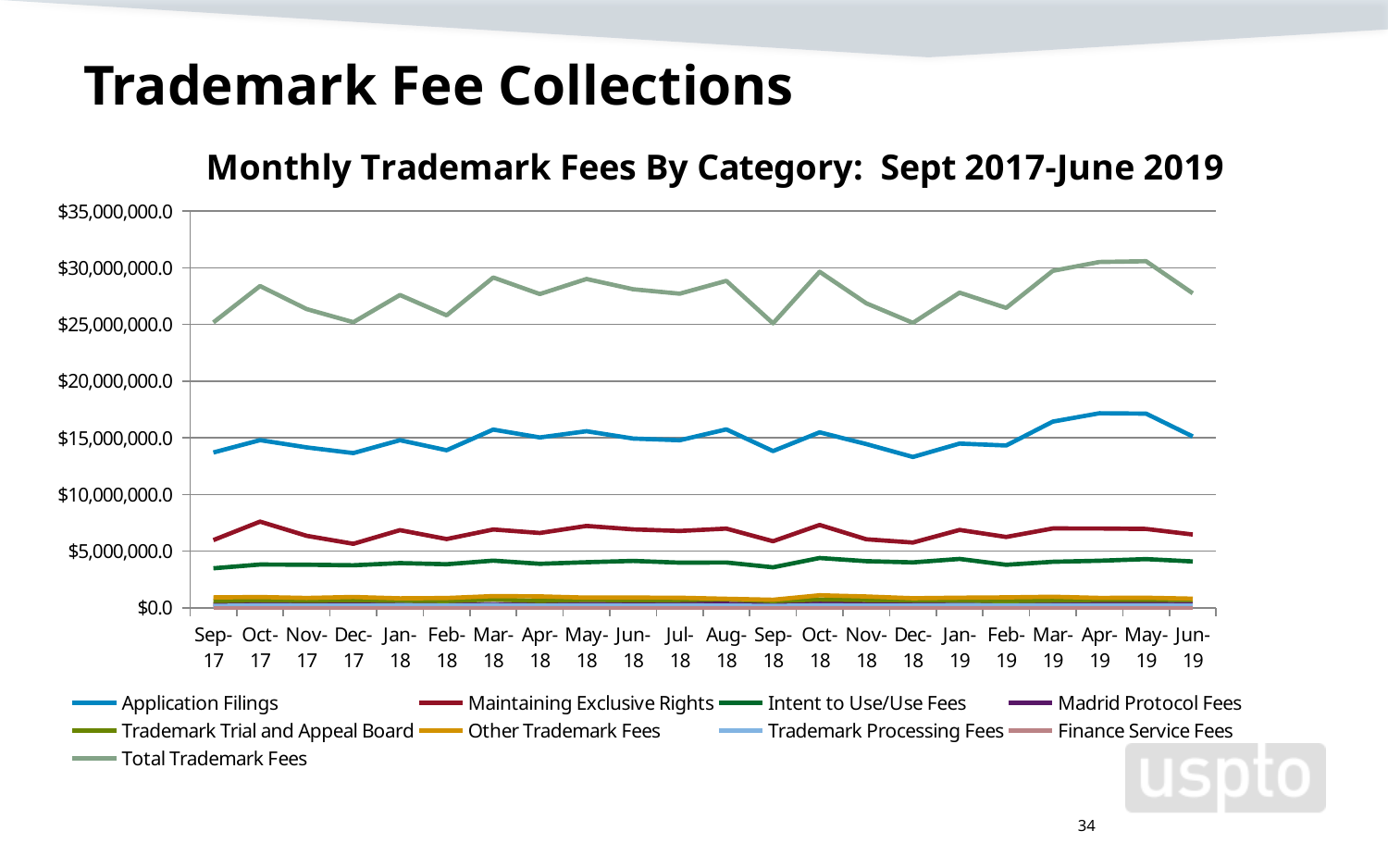
What is the title of the chart? Monthly Trademark Fees By Category: Sept 2017-June 2019 Is the value for Total Trademark Fees in Sep-17 greater or less than $30,000,000.0? less Is the value for Intent to Use/Use Fees in Sep-17 greater or less than $5,000,000.0? less Which is larger, Total Trademark Fees in Oct-18 or in Sep-18? Oct-18 Do Application Filings rise or fall from Feb-19 to May-19? rise Is the value for Application Filings in May-19 greater or less than $15,000,000.0? greater How many months are plotted along the x axis? 22 How many series does the legend list? 9 What kind of chart is shown on the slide? line chart Which series has the highest values throughout the chart? Total Trademark Fees